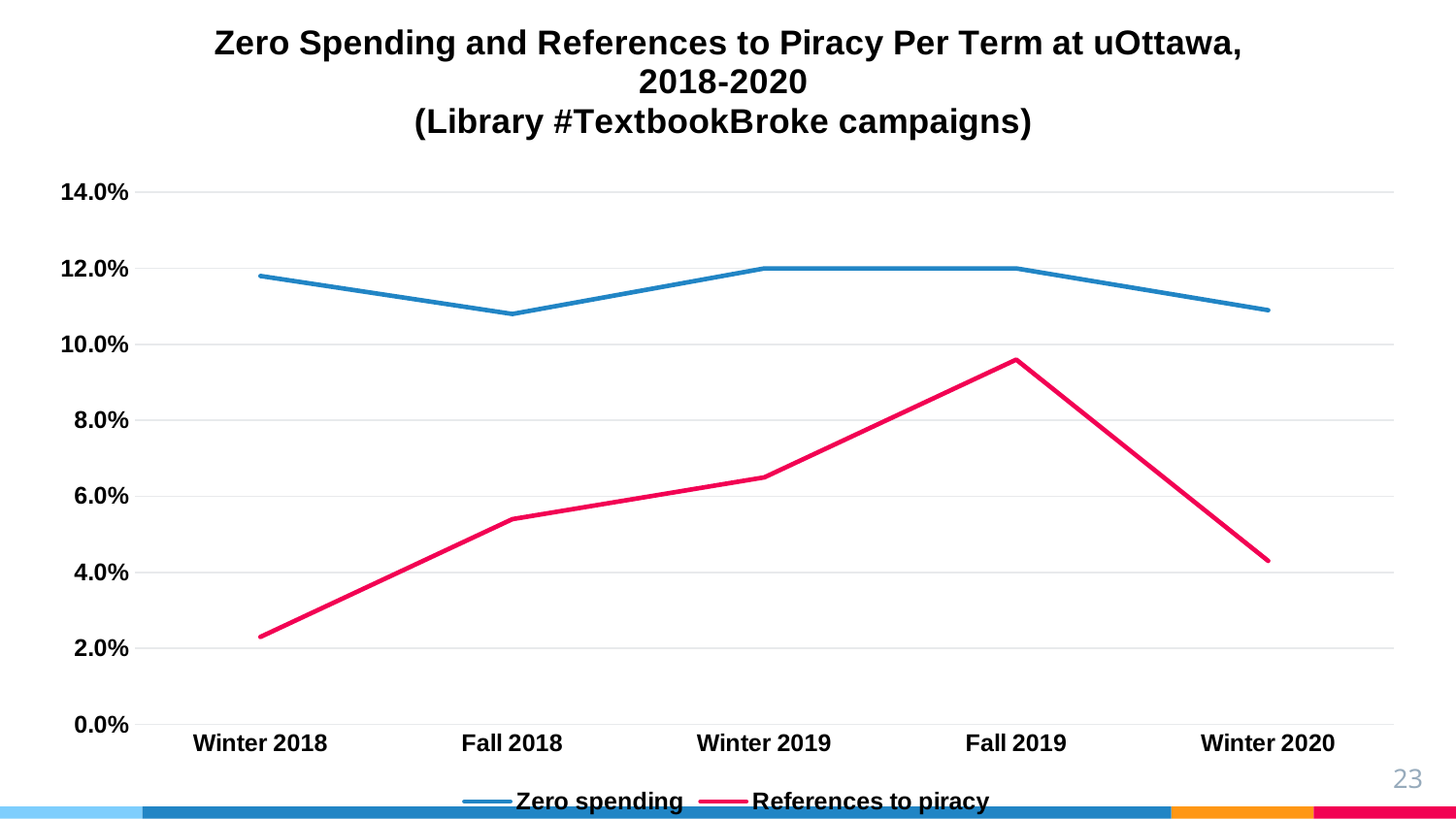
Which series is drawn in red? References to piracy In Fall 2019, which series has the larger value, Zero spending or References to piracy? Zero spending How many series does the legend list? 2 Is the References to piracy value for Winter 2018 greater or less than 4.0%? less In which term is the References to piracy value highest? Fall 2019 How many terms are shown on the x axis? 5 Is the References to piracy value for Fall 2019 greater or less than 8.0%? greater Does the References to piracy line rise or fall from Winter 2018 to Fall 2019? Rise What kind of chart is shown on the slide? Line chart Is the References to piracy value for Winter 2020 greater or less than 6.0%? less In which term is the References to piracy value lowest? Winter 2018